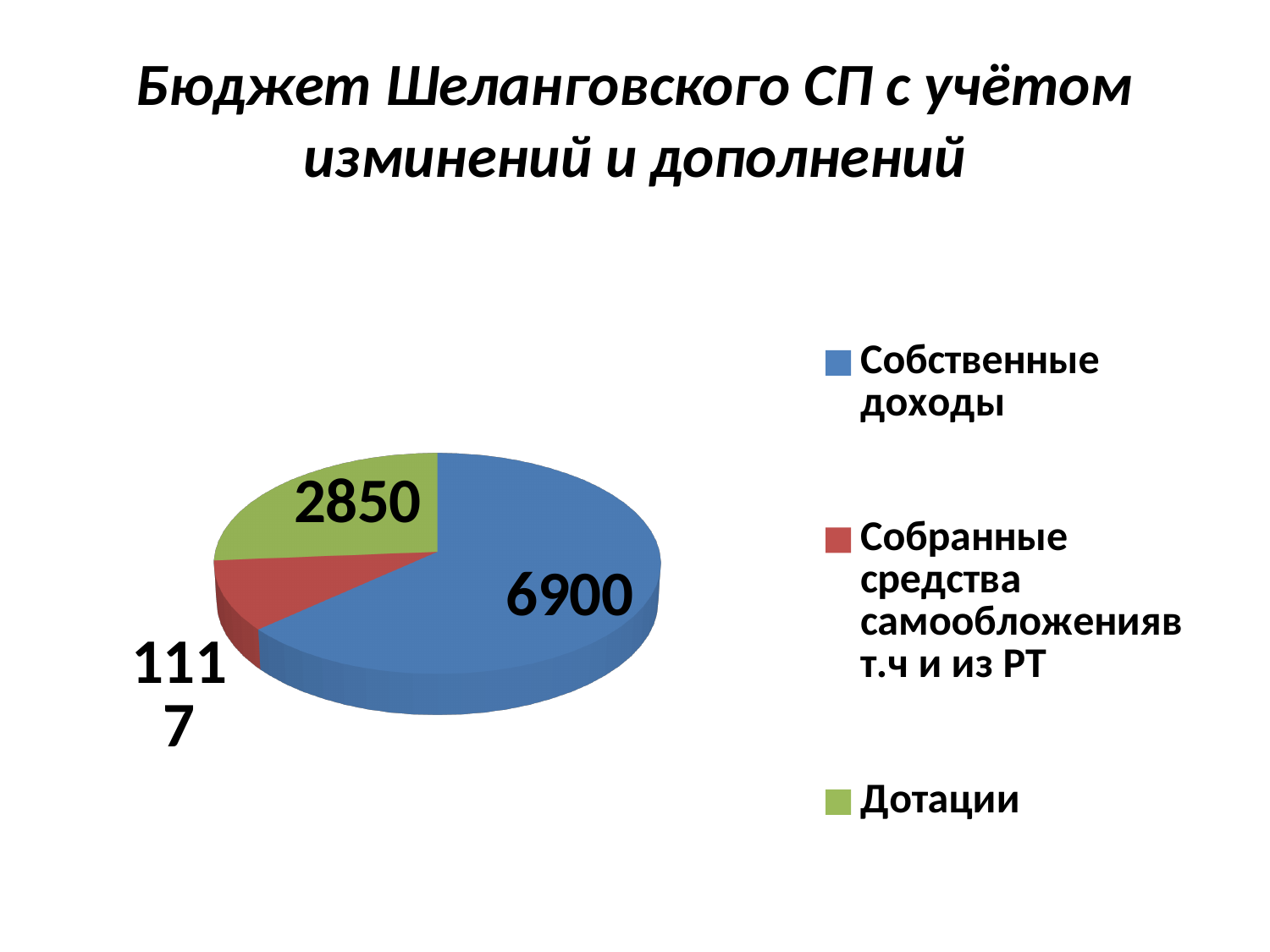
What is the difference between the values for Собственные доходы and Дотации? 4050 What is the difference between the values for Дотации and Собранные средства самообложения в т.ч и из РТ? 1733 What is the value for Дотации? 2850 What is the value for Собранные средства самообложения в т.ч и из РТ? 1117 Which category has the smallest slice of the pie? Собранные средства самообложения в т.ч и из РТ Which category has the largest slice of the pie? Собственные доходы What is the total of all the values shown in the pie chart? 10867 Which is larger, the value for Дотации or the value for Собранные средства самообложения в т.ч и из РТ? Дотации What colour is the slice for Дотации? Green What is the value for Собственные доходы? 6900 What type of chart is shown on the slide? Pie chart How many slices does the pie chart have? 3